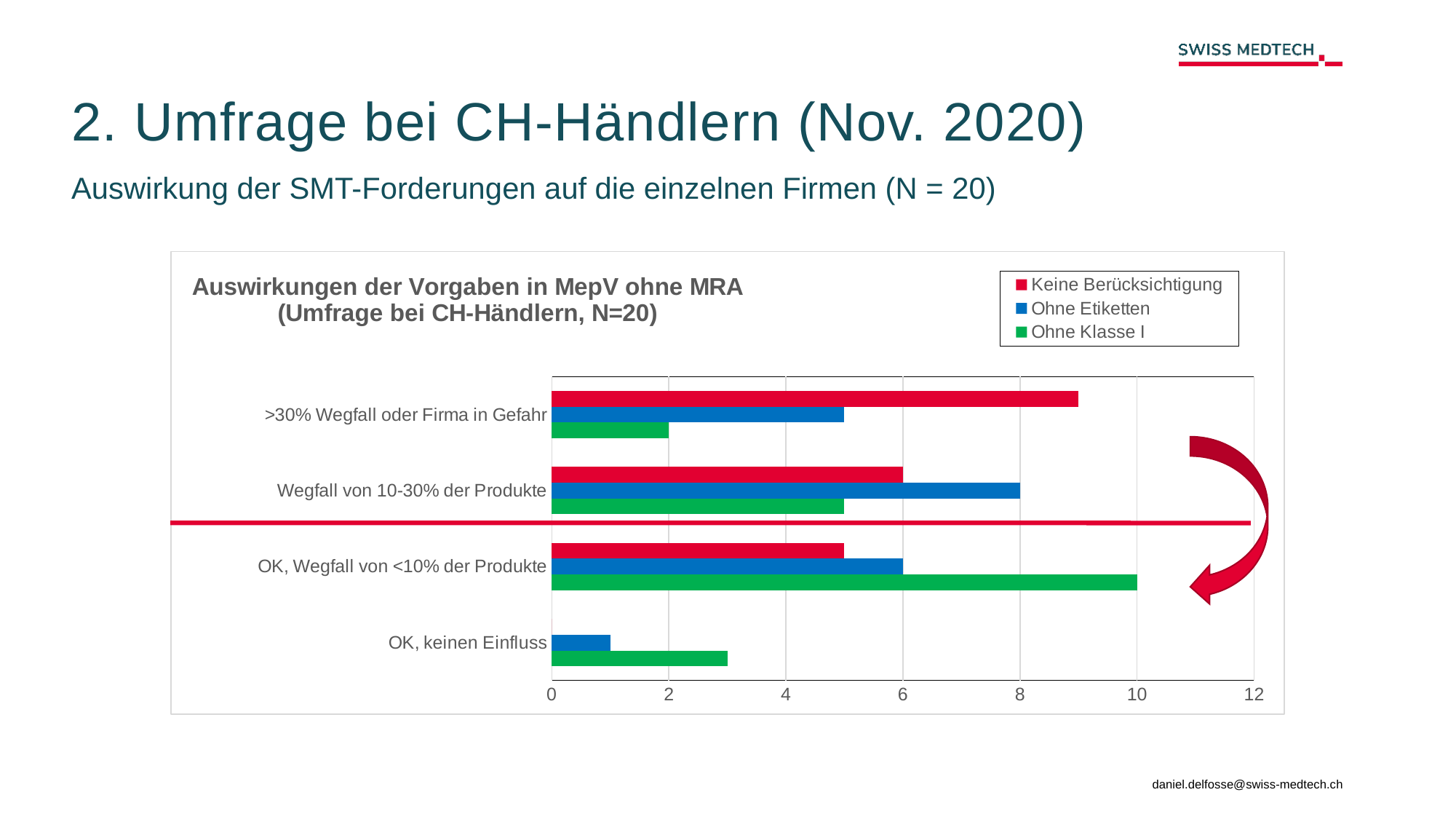
Is the value for 'Keine Berücksichtigung' in the category '>30% Wegfall oder Firma in Gefahr' greater or less than 8? greater In the category 'OK, Wegfall von <10% der Produkte', which series has the larger value: 'Ohne Klasse I' or 'Keine Berücksichtigung'? Ohne Klasse I Is the value for 'Ohne Etiketten' in the category 'OK, keinen Einfluss' greater or less than 2? less What is the value for 'Ohne Klasse I' in the category '>30% Wegfall oder Firma in Gefahr'? 2 Which category has the highest value for the 'Ohne Klasse I' series? OK, Wegfall von <10% der Produkte What is the value for 'Keine Berücksichtigung' in the category 'Wegfall von 10-30% der Produkte'? 6 What kind of chart is shown on the slide? bar chart Which series is shown in red in the legend? Keine Berücksichtigung How many categories are shown on the vertical axis of the chart? 4 What is the value for 'Ohne Etiketten' in the category 'Wegfall von 10-30% der Produkte'? 8 How many series does the legend list? 3 What is the value for 'Ohne Klasse I' in the category 'OK, Wegfall von <10% der Produkte'? 10